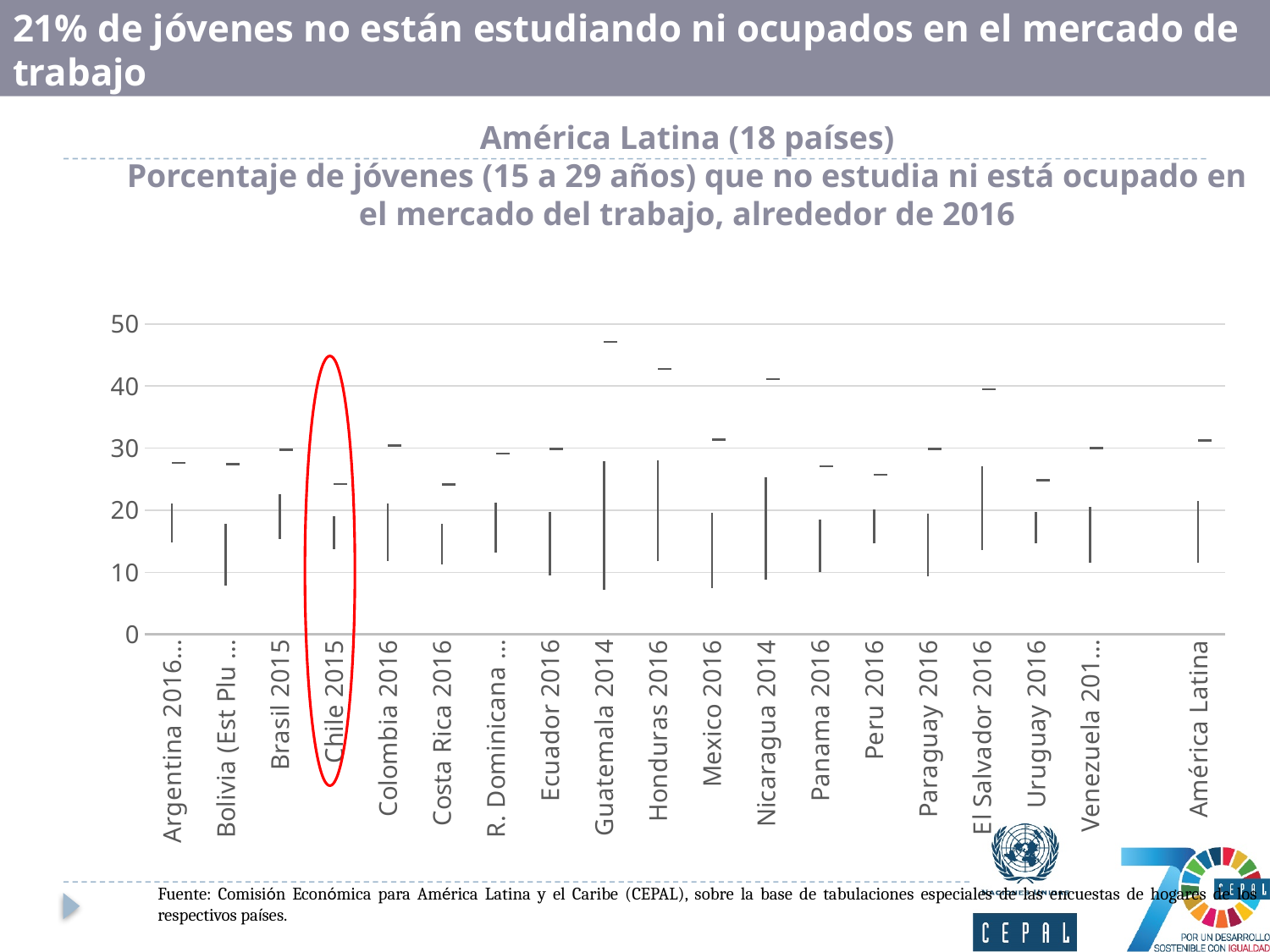
Which has the higher marker value, Honduras 2016 or Costa Rica 2016? Honduras 2016 Is the marker value for Guatemala 2014 greater or less than 40? greater Is the marker value for Honduras 2016 greater or less than 40? greater Is the marker value for Argentina 2016 greater or less than 30? less What is the highest value shown on the y axis of the chart? 50 Which has the higher marker value, Guatemala 2014 or Chile 2015? Guatemala 2014 How many categories are shown along the x axis of the chart? 19 Which category on the x axis is circled in red? Chile 2015 Which category has the highest marker on the chart? Guatemala 2014